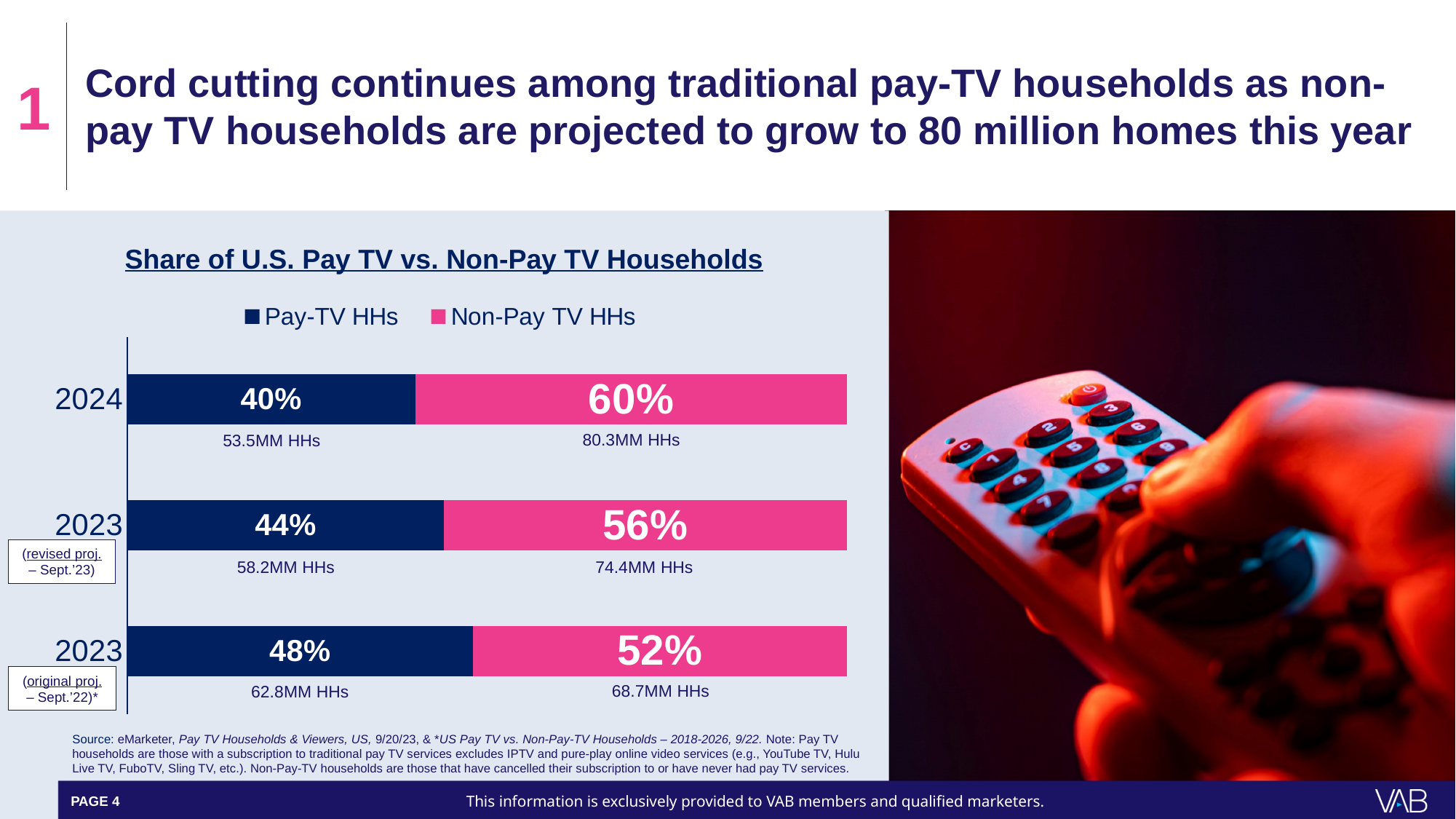
What is the Non-Pay TV HHs share for 2024? 60% Which bar has the lowest Pay-TV HHs share? 2024 What type of chart is shown on the slide? Stacked bar chart What is the Pay-TV HHs share for 2024? 40% How many Non-Pay TV households are shown for 2024? 80.3MM HHs What is the Non-Pay TV HHs share for 2023 (revised proj. – Sept.'23)? 56% How many Pay-TV households are shown for 2023 (revised proj. – Sept.'23)? 58.2MM HHs Which is larger for 2023 (original proj. – Sept.'22): the Pay-TV HHs share or the Non-Pay TV HHs share? Non-Pay TV HHs How many series does the legend list? 2 What is the Pay-TV HHs share for 2023 (original proj. – Sept.'22)? 48% Which bar has the highest Non-Pay TV HHs share? 2024 What is the difference between the Non-Pay TV HHs share and the Pay-TV HHs share in 2024? 20%